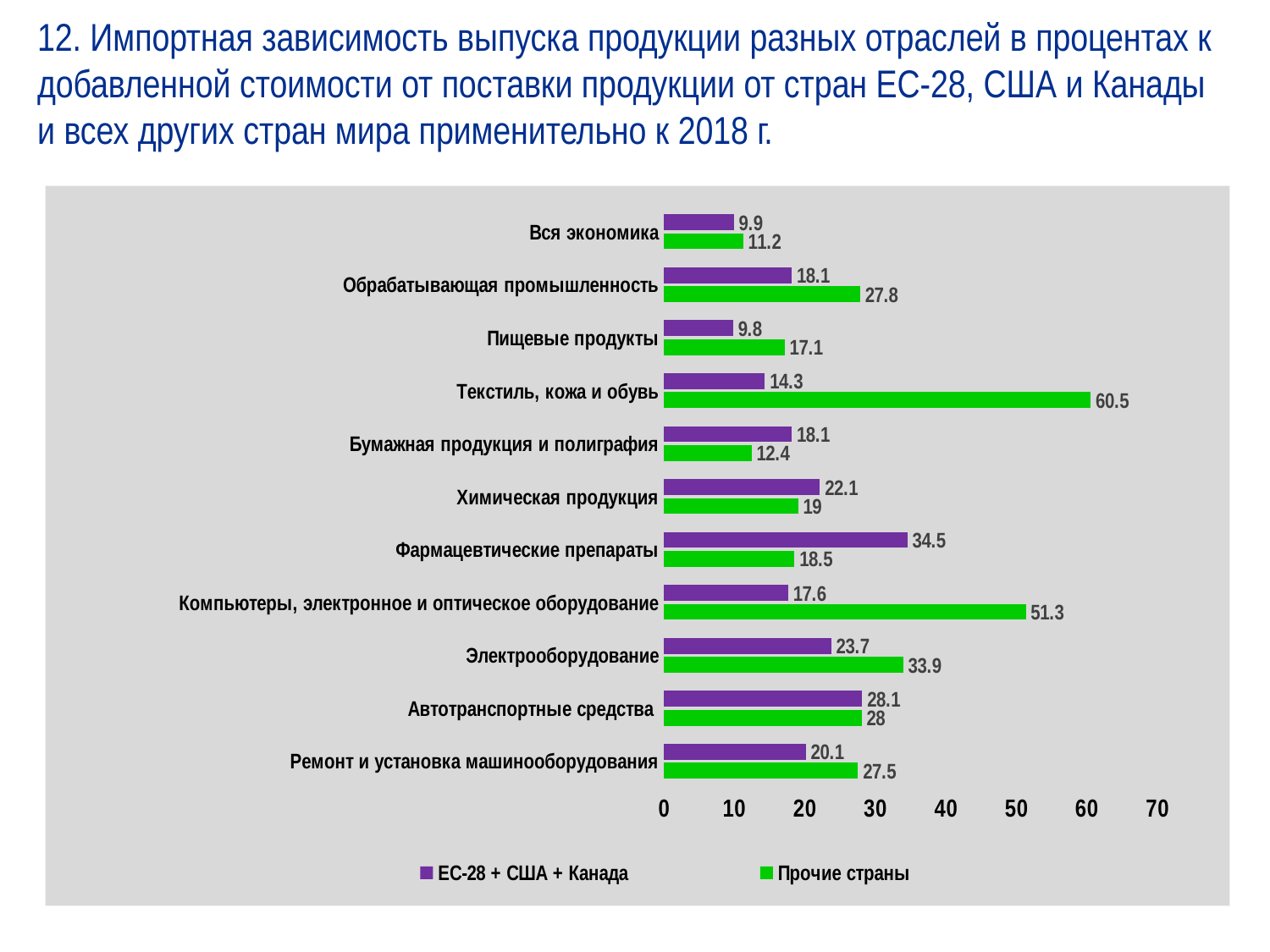
What is the value for Вся экономика in the Прочие страны series? 11.2 What is the difference between the Прочие страны and ЕС-28 + США + Канада values for Компьютеры, электронное и оптическое оборудование? 33.7 For Бумажная продукция и полиграфия, which series has the larger value: ЕС-28 + США + Канада or Прочие страны? ЕС-28 + США + Канада What is the value for Текстиль, кожа и обувь in the Прочие страны series? 60.5 What is the value for Фармацевтические препараты in the ЕС-28 + США + Канада series? 34.5 How many categories are shown on the chart? 11 What is the value for Электрооборудование in the Прочие страны series? 33.9 What kind of chart is shown on the slide? Bar chart Which colour represents the Прочие страны series? Green Which category has the lowest value in the ЕС-28 + США + Канада series? Пищевые продукты Which category has the highest value in the Прочие страны series? Текстиль, кожа и обувь How many series does the legend list? 2